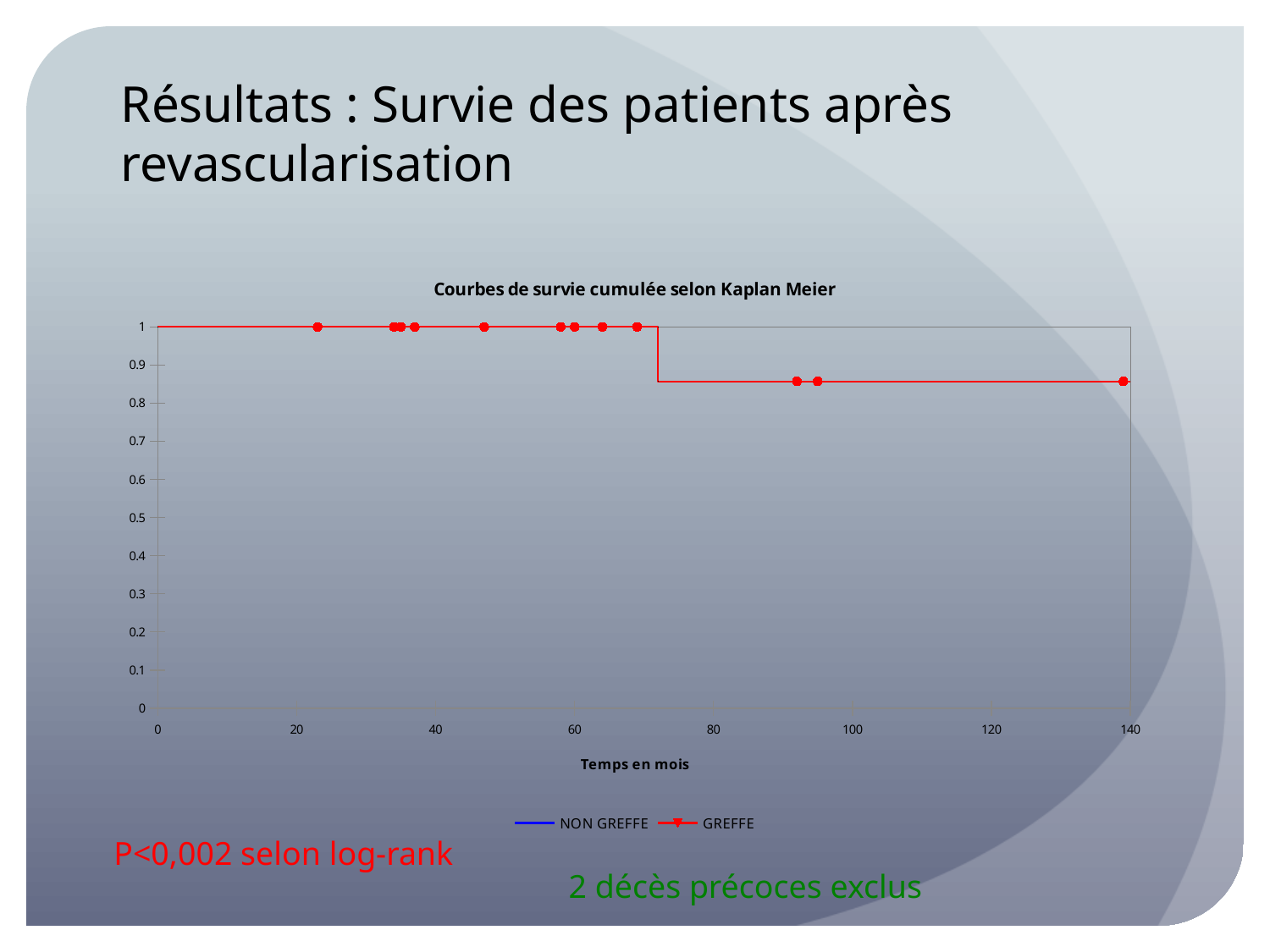
What is the label of the x axis? Temps en mois Is the value of the GREFFE series at 40 months greater or less than 0.9? greater How many series does the chart legend list? 2 Does the GREFFE survival curve rise or fall as time increases along the x axis? fall Is the value of the GREFFE series at 120 months greater or less than 0.5? greater What kind of chart is shown on the slide? line chart What is the cumulative survival value of the GREFFE series at 20 months? 1 What is the title of the chart? Courbes de survie cumulée selon Kaplan Meier Is the value of the GREFFE series at 100 months greater or less than 0.8? greater What is the highest value shown on the y axis? 1 What is the cumulative survival value of the GREFFE series at 60 months? 1